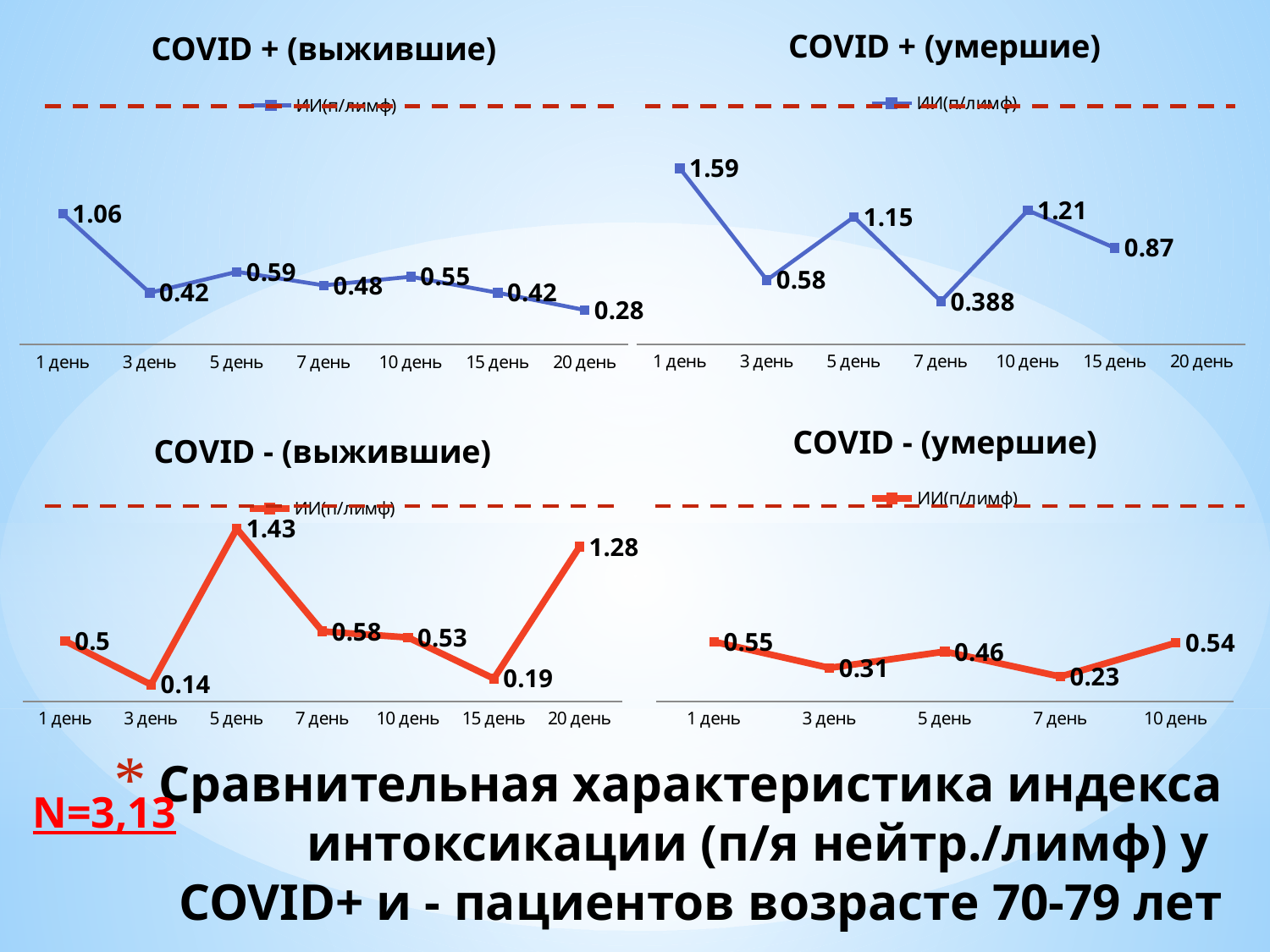
In the chart titled "COVID + (умершие)", what is the value for 7 день? 0.388 In the chart titled "COVID + (выжившие)", which day has the lowest value? 20 день In the chart titled "COVID - (выжившие)", which day has the highest value? 5 день In the chart titled "COVID - (умершие)", which is larger: the value for 1 день or the value for 7 день? 1 день In the chart titled "COVID - (умершие)", what is the value for 3 день? 0.31 In the chart titled "COVID + (умершие)", what is the difference between the values for 1 день and 3 день? 1.01 What kind of chart is the chart titled "COVID + (умершие)"? Line chart What is the legend entry shown in the chart titled "COVID - (умершие)"? ИИ(п/лимф) In the chart titled "COVID - (выжившие)", what is the value for 20 день? 1.28 How many day categories are shown on the x axis of the chart titled "COVID - (умершие)"? 5 In the chart titled "COVID + (выжившие)", does the value rise or fall from 1 день to 3 день? Fall In the chart titled "COVID + (выжившие)", what is the value for 1 день? 1.06